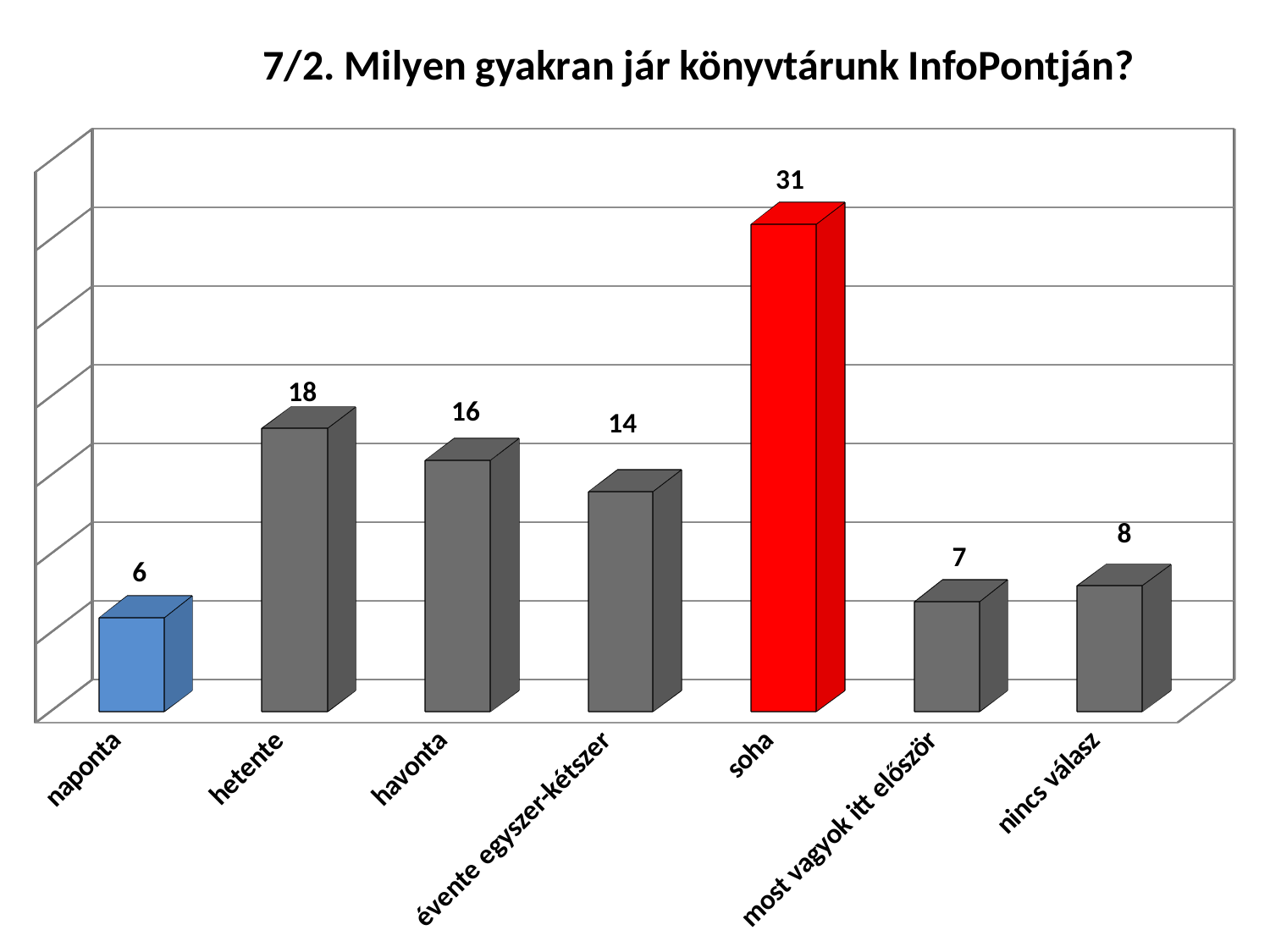
What is the difference between the values for "havonta" and "évente egyszer-kétszer"? 2 What is the value for "hetente"? 18 Which category's bar is coloured red? soha What kind of chart is shown on the slide? bar chart Which is larger, the value for "nincs válasz" or the value for "naponta"? nincs válasz Which category has the highest value? soha What is the value for "soha"? 31 What is the title of the chart? 7/2. Milyen gyakran jár könyvtárunk InfoPontján? What is the difference between the values for "soha" and "hetente"? 13 How many categories are shown on the x axis? 7 Which category has the lowest value? naponta What is the value for "most vagyok itt először"? 7